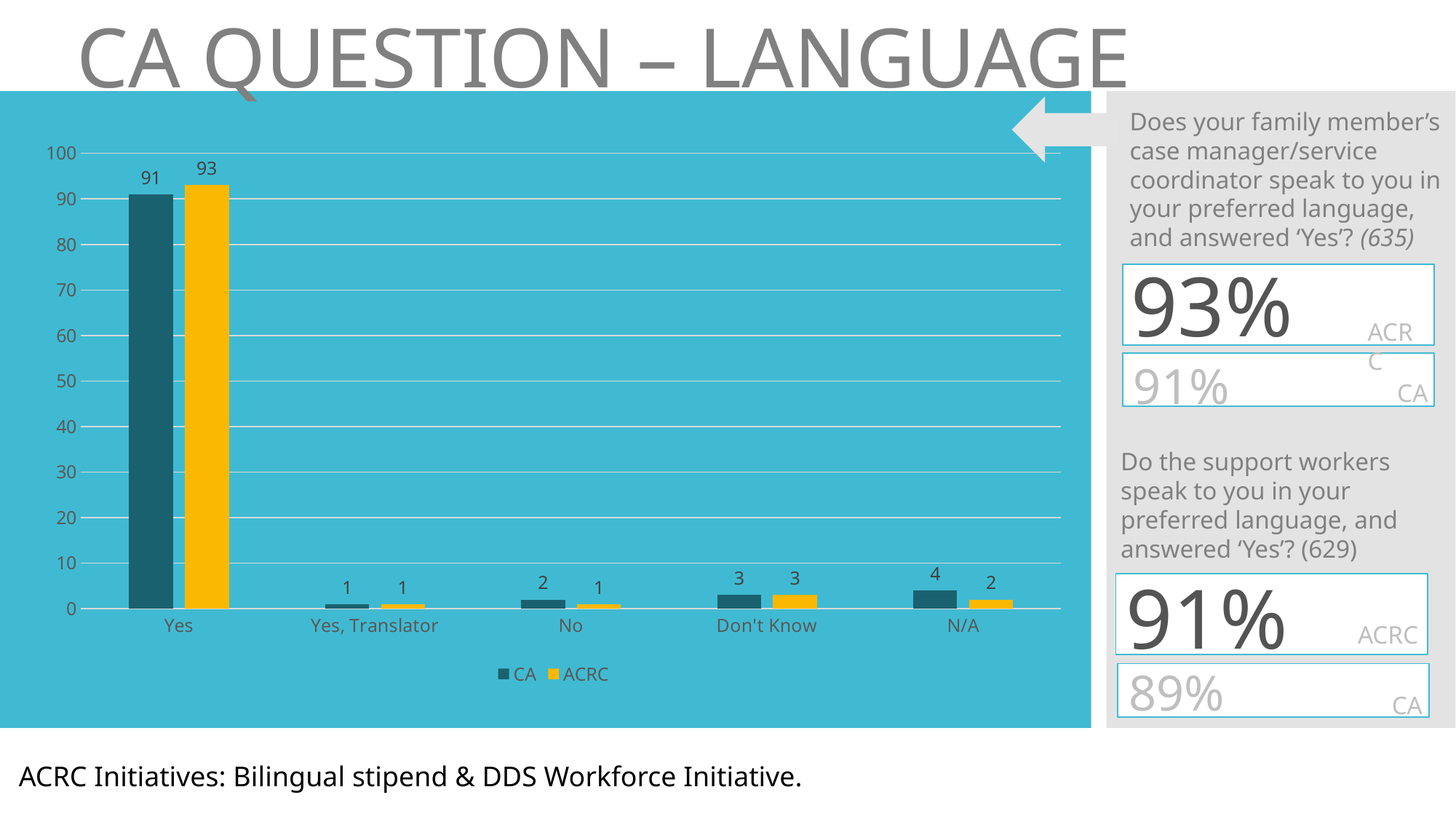
What is the value for ACRC in the 'Yes' category? 93 What is the value for CA in the 'N/A' category? 4 What is the value for CA in the 'Yes' category? 91 Which category has the highest value for the ACRC series? Yes How many series does the legend list? 2 In the 'N/A' category, which series has the larger value, CA or ACRC? CA What kind of chart is shown on the slide? Bar chart Which category has the lowest value for the CA series? Yes, Translator How many categories are shown on the x axis? 5 What is the difference between the ACRC and CA values in the 'Yes' category? 2 What is the value for ACRC in the 'No' category? 1 What colour are the bars for the ACRC series? Yellow